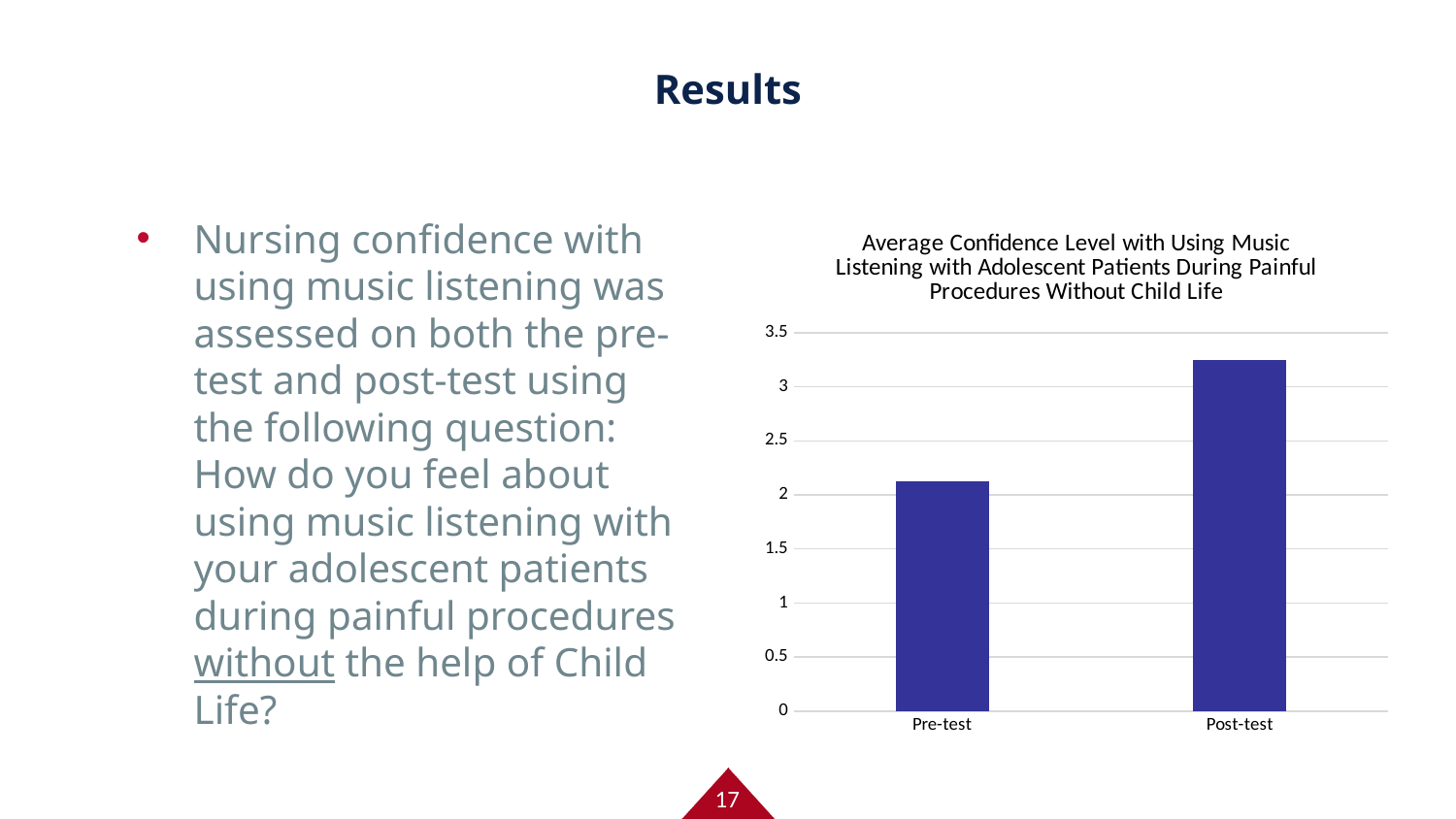
Is the value for Pre-test greater or less than 2.5? less Do the values rise or fall from Pre-test to Post-test? rise Is the value for Pre-test greater or less than 1.5? greater What kind of chart is shown on the slide? bar chart What is the highest value shown on the chart's vertical axis? 3.5 Which category has the lower average confidence level? Pre-test Is the value for Post-test greater or less than 3.5? less Which category has the higher average confidence level? Post-test Is the Post-test value larger or smaller than the Pre-test value? larger What is the title of the chart? Average Confidence Level with Using Music Listening with Adolescent Patients During Painful Procedures Without Child Life How many categories are plotted in the chart? 2